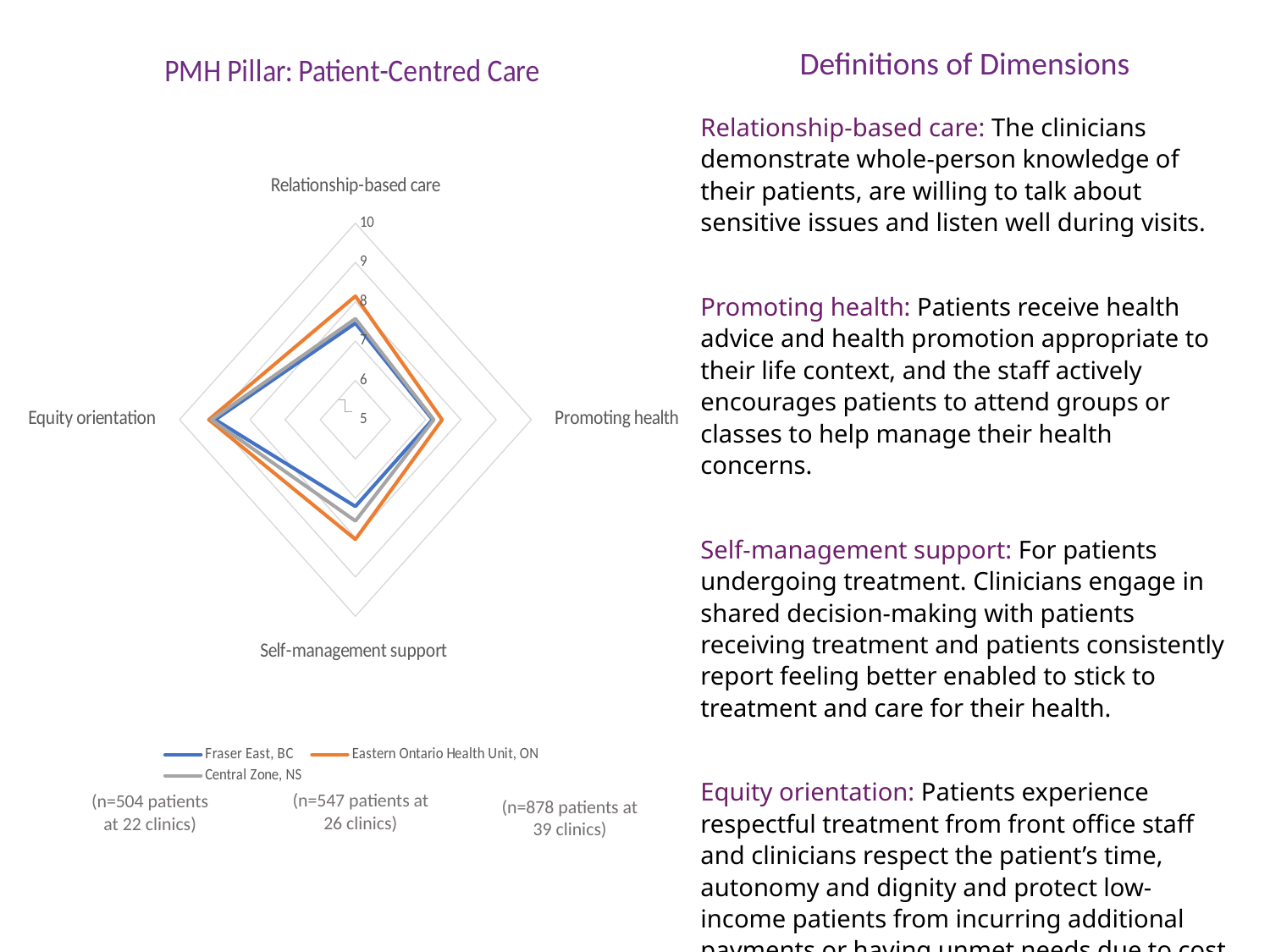
On which dimension does Eastern Ontario Health Unit, ON score highest? Equity orientation Is the value for Eastern Ontario Health Unit, ON on Relationship-based care greater or less than 7? greater Which series is drawn in orange on the chart? Eastern Ontario Health Unit, ON Which series has the lowest value on Self-management support? Fraser East, BC Is the value for Fraser East, BC on Self-management support greater or less than 8? less What kind of chart is shown on the slide? Radar chart How many dimensions (axes) does the radar chart plot? 4 What is the title of the chart? PMH Pillar: Patient-Centred Care Is the value for Fraser East, BC on Promoting health greater or less than 9? less How many series does the chart legend list? 3 On Self-management support, which series has the higher value: Fraser East, BC or Eastern Ontario Health Unit, ON? Eastern Ontario Health Unit, ON